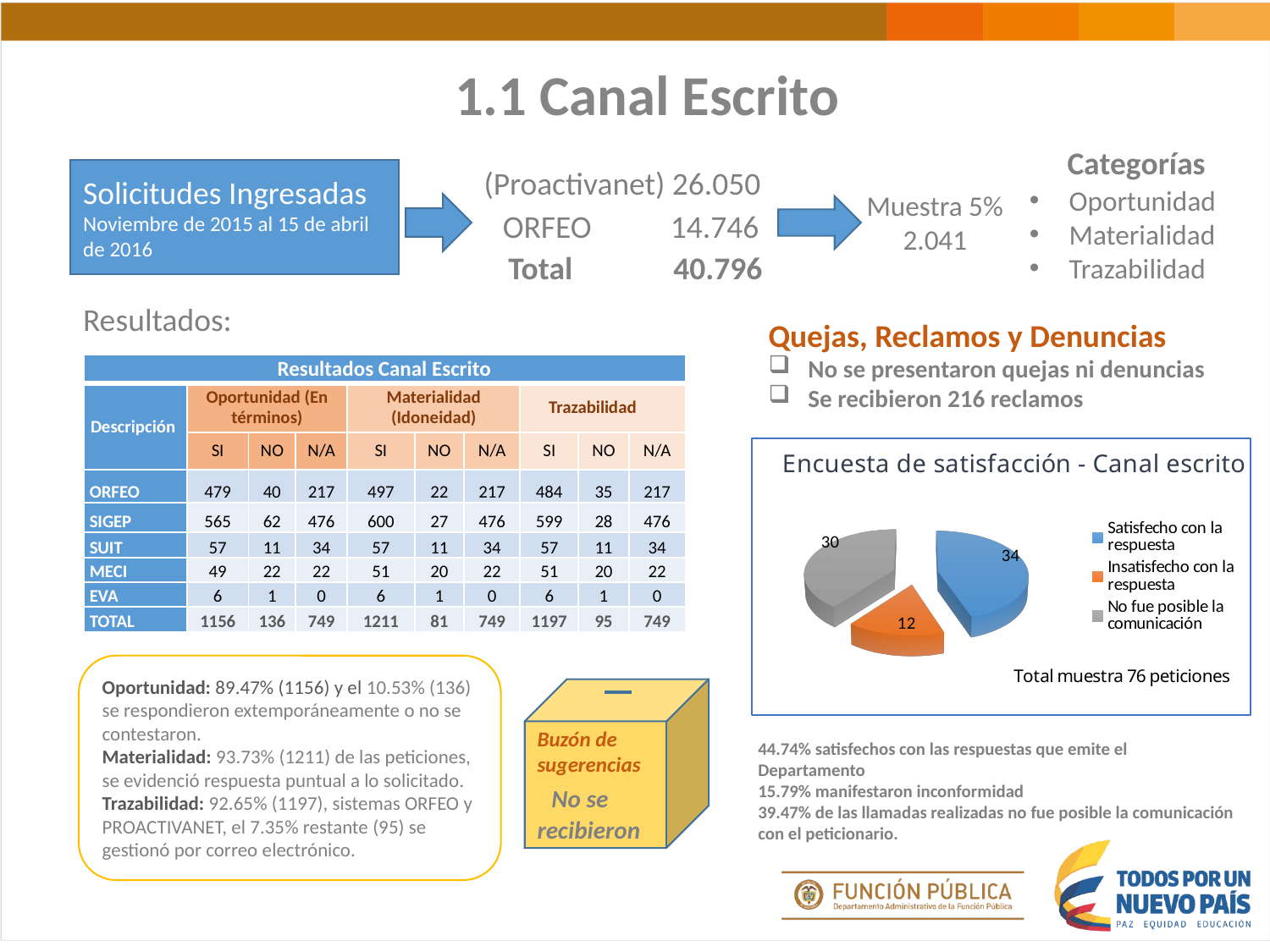
In the pie chart "Encuesta de satisfacción - Canal escrito", which category has the largest slice? Satisfecho con la respuesta In the pie chart "Encuesta de satisfacción - Canal escrito", what is the value for "Insatisfecho con la respuesta"? 12 What type of chart is shown under the title "Encuesta de satisfacción - Canal escrito"? pie chart In the pie chart "Encuesta de satisfacción - Canal escrito", which is larger: "No fue posible la comunicación" or "Insatisfecho con la respuesta"? No fue posible la comunicación How many entries does the legend of the pie chart "Encuesta de satisfacción - Canal escrito" list? 3 In the pie chart "Encuesta de satisfacción - Canal escrito", which category has the smallest slice? Insatisfecho con la respuesta In the pie chart "Encuesta de satisfacción - Canal escrito", what is the difference between the values for "Satisfecho con la respuesta" and "Insatisfecho con la respuesta"? 22 In the pie chart "Encuesta de satisfacción - Canal escrito", what is the value for "No fue posible la comunicación"? 30 How many slices does the pie chart "Encuesta de satisfacción - Canal escrito" have? 3 In the pie chart "Encuesta de satisfacción - Canal escrito", what is the value for "Satisfecho con la respuesta"? 34 What is the total number of petitions represented in the pie chart "Encuesta de satisfacción - Canal escrito"? 76 In the pie chart "Encuesta de satisfacción - Canal escrito", what colour is the slice for "No fue posible la comunicación"? gray